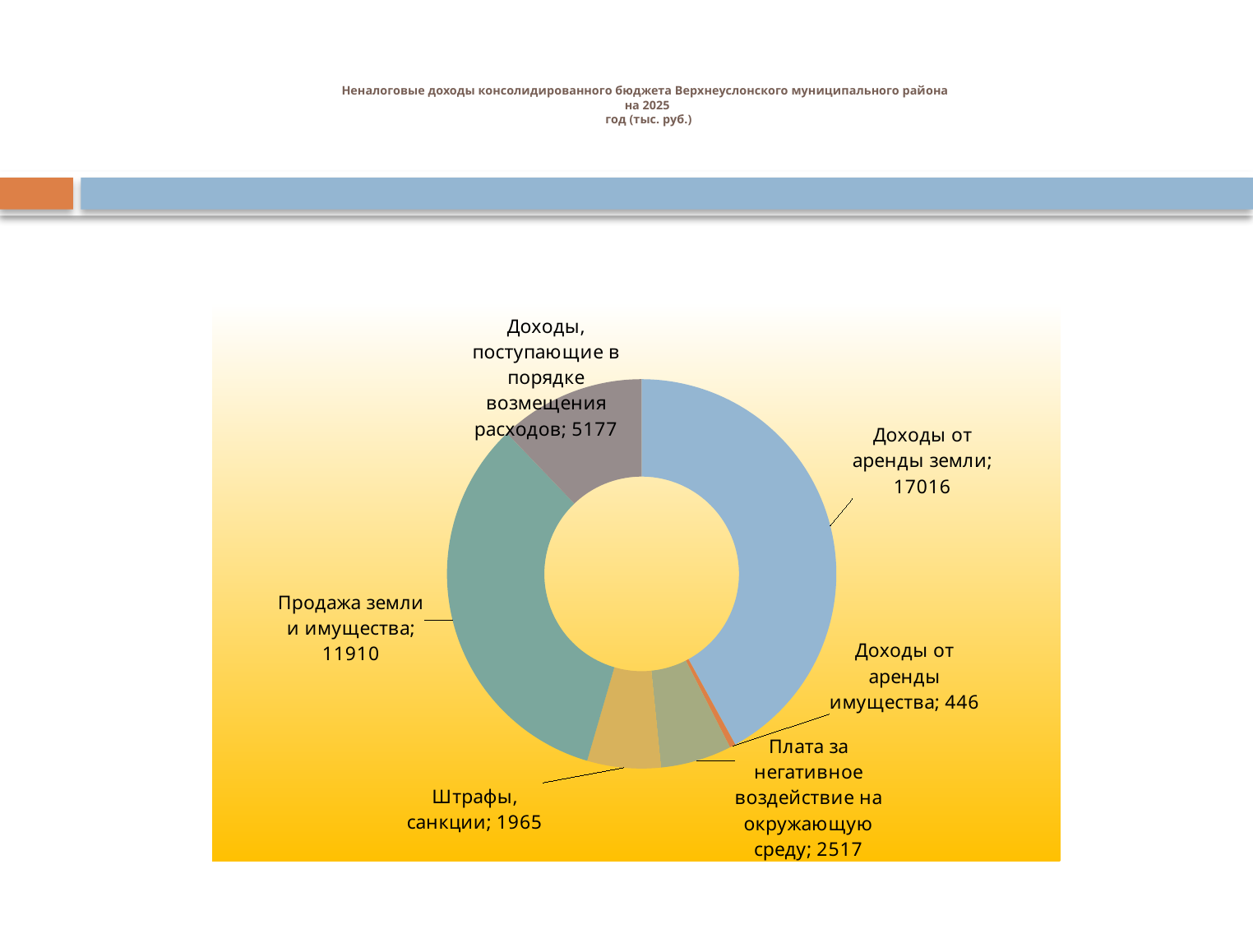
What is the value for Плата за негативное воздействие на окружающую среду? 2517 What is the total of all categories shown in the chart? 39031 Which category has the largest value? Доходы от аренды земли Which category has the smallest value? Доходы от аренды имущества What is the value for Продажа земли и имущества? 11910 How many categories does the chart show? 6 What is the value for Доходы от аренды земли? 17016 Which is larger: Штрафы, санкции or Плата за негативное воздействие на окружающую среду? Плата за негативное воздействие на окружающую среду What is the difference between Доходы, поступающие в порядке возмещения расходов and Штрафы, санкции? 3212 What kind of chart is shown on the slide? Doughnut (pie) chart What is the value for Штрафы, санкции? 1965 What is the difference between Доходы от аренды земли and Продажа земли и имущества? 5106